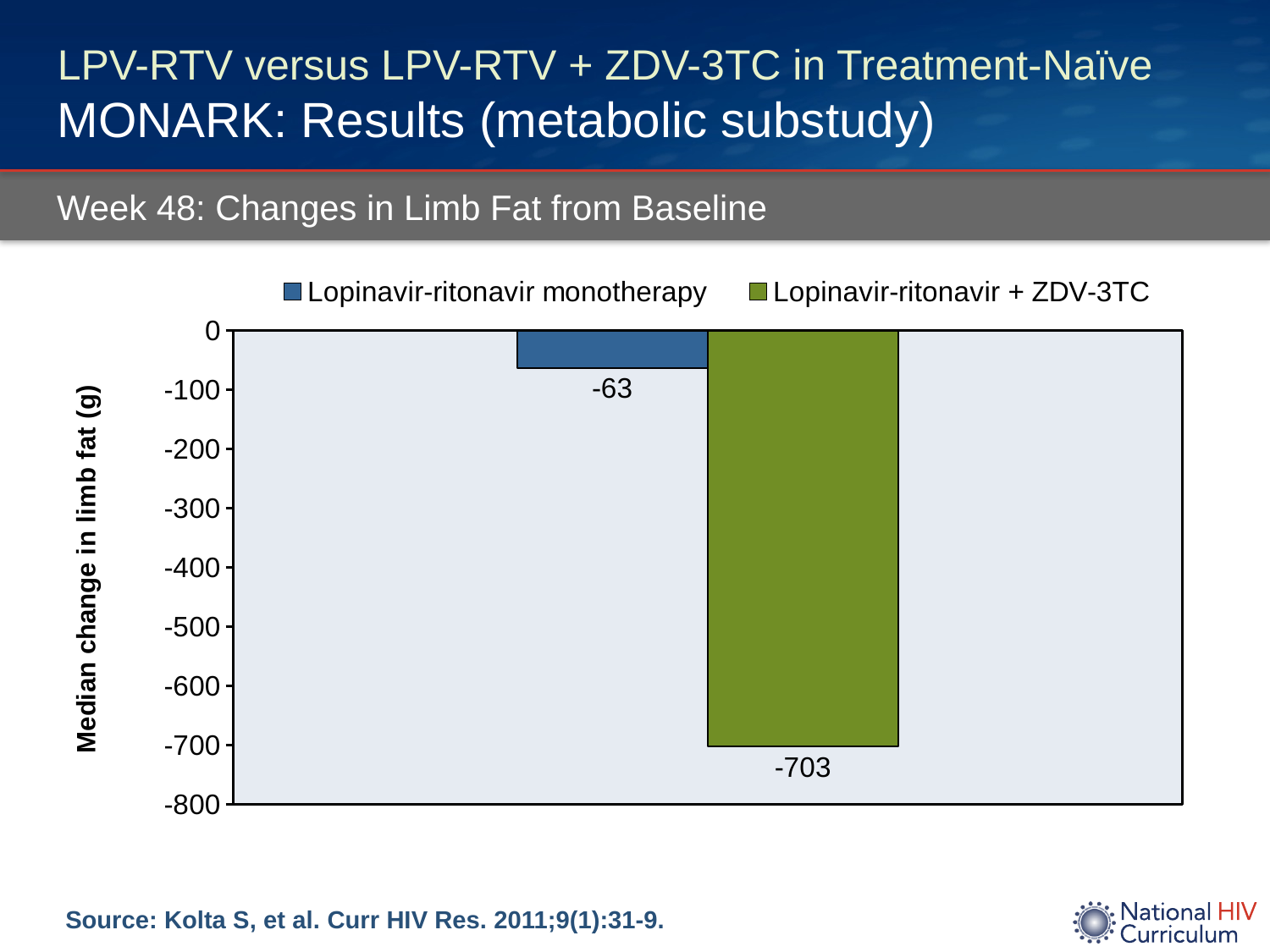
How many series does the legend list? 2 What is the median change in limb fat for Lopinavir-ritonavir monotherapy? -63 How many bars are plotted in the chart? 2 What is the label of the y axis? Median change in limb fat (g) What is the median change in limb fat for Lopinavir-ritonavir + ZDV-3TC? -703 Which series shows the smaller decrease in limb fat? Lopinavir-ritonavir monotherapy What is the difference between the limb fat changes for Lopinavir-ritonavir + ZDV-3TC and Lopinavir-ritonavir monotherapy? 640 Is the value for Lopinavir-ritonavir monotherapy greater or less than -100? greater Is the value for Lopinavir-ritonavir + ZDV-3TC greater or less than -500? less What colour is the bar for Lopinavir-ritonavir + ZDV-3TC? Green What kind of chart is shown on the slide? Bar chart Which series shows the larger decrease in limb fat? Lopinavir-ritonavir + ZDV-3TC